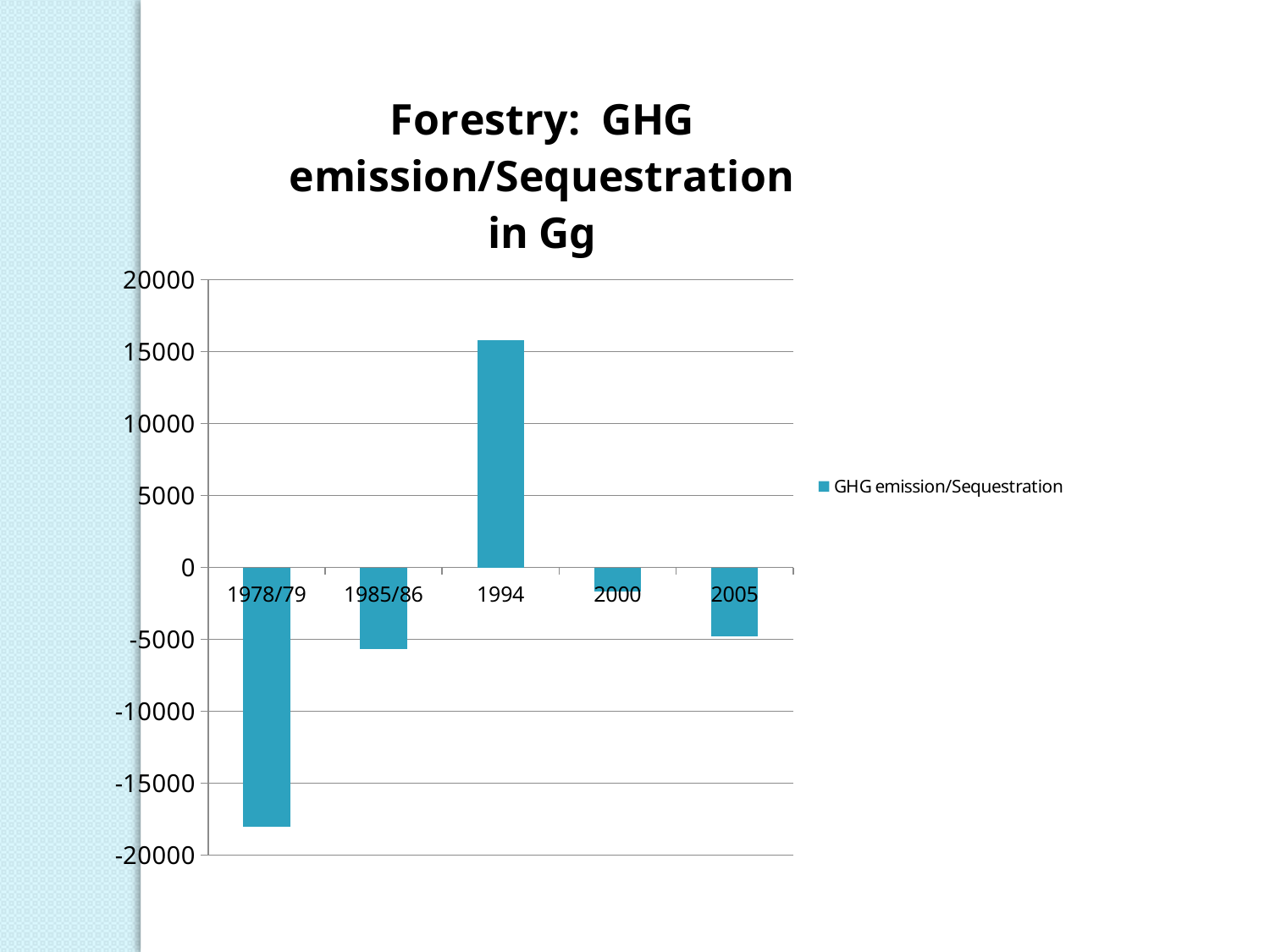
Which year has the lowest GHG emission/Sequestration value? 1978/79 Which is larger, the value for 2000 or the value for 1978/79? 2000 Is the value for 1994 greater or less than 15000? greater What type of chart is shown on the slide? Bar chart How many categories (years) are shown on the x axis of the chart? 5 How many years in the chart have a negative GHG emission/Sequestration value? 4 Is the value for 2000 greater or less than -5000? greater How many series does the chart's legend list? 1 Which year has the highest GHG emission/Sequestration value? 1994 What is the title of the chart? Forestry: GHG emission/Sequestration in Gg Is the value for 1978/79 greater or less than -15000? less